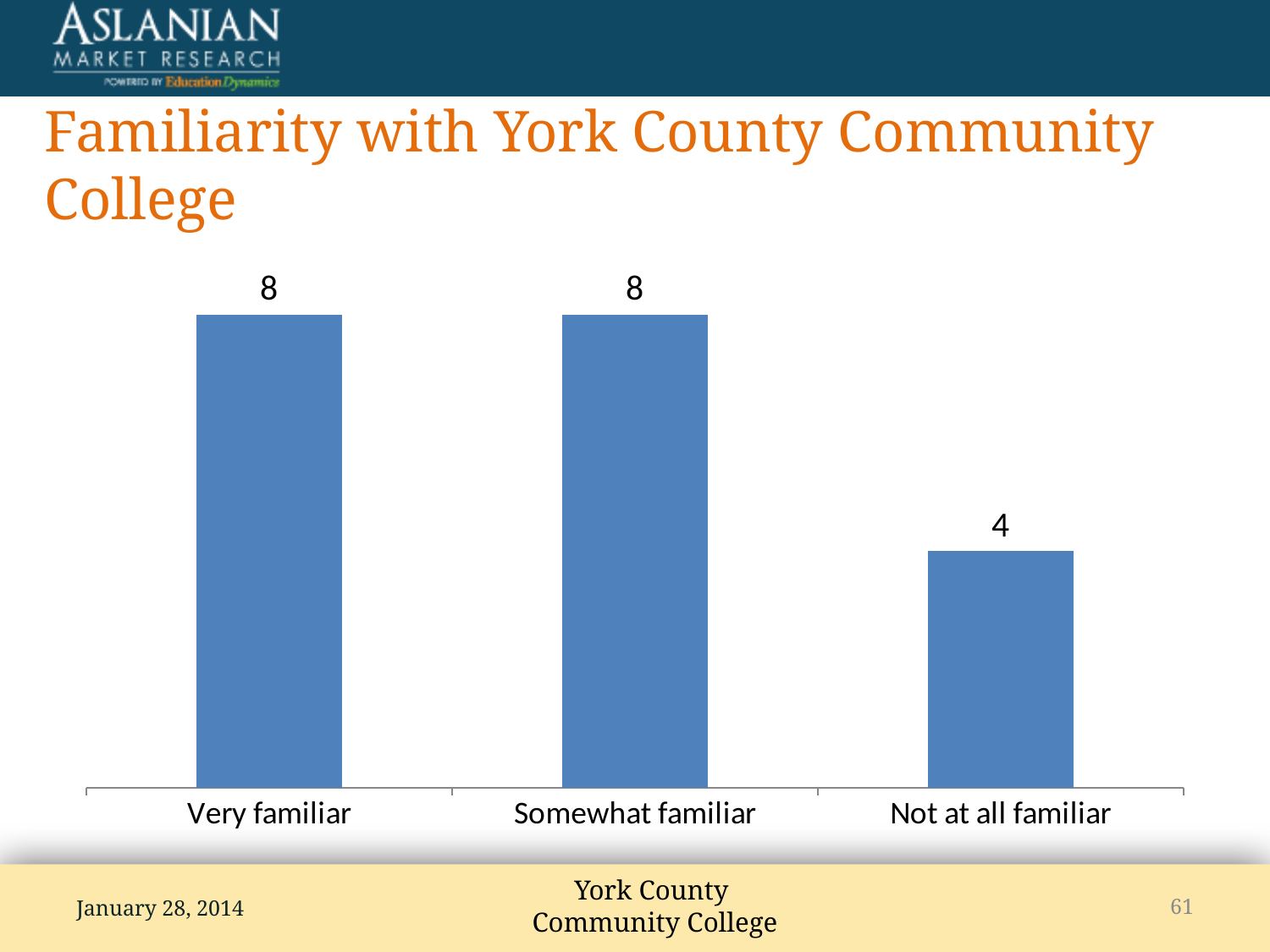
Which category has the lowest value? Not at all familiar What is the title of the slide containing the chart? Familiarity with York County Community College What is the value for Very familiar? 8 Which is larger, the value for Somewhat familiar or the value for Not at all familiar? Somewhat familiar How many categories are shown on the x axis? 3 What kind of chart is shown on the slide? Bar chart What is the value for Not at all familiar? 4 What colour are the bars in the chart? Blue What is the value for Somewhat familiar? 8 What is the difference between the values for Somewhat familiar and Not at all familiar? 4 Are the values for Very familiar and Somewhat familiar equal? Yes What is the difference between the values for Very familiar and Not at all familiar? 4